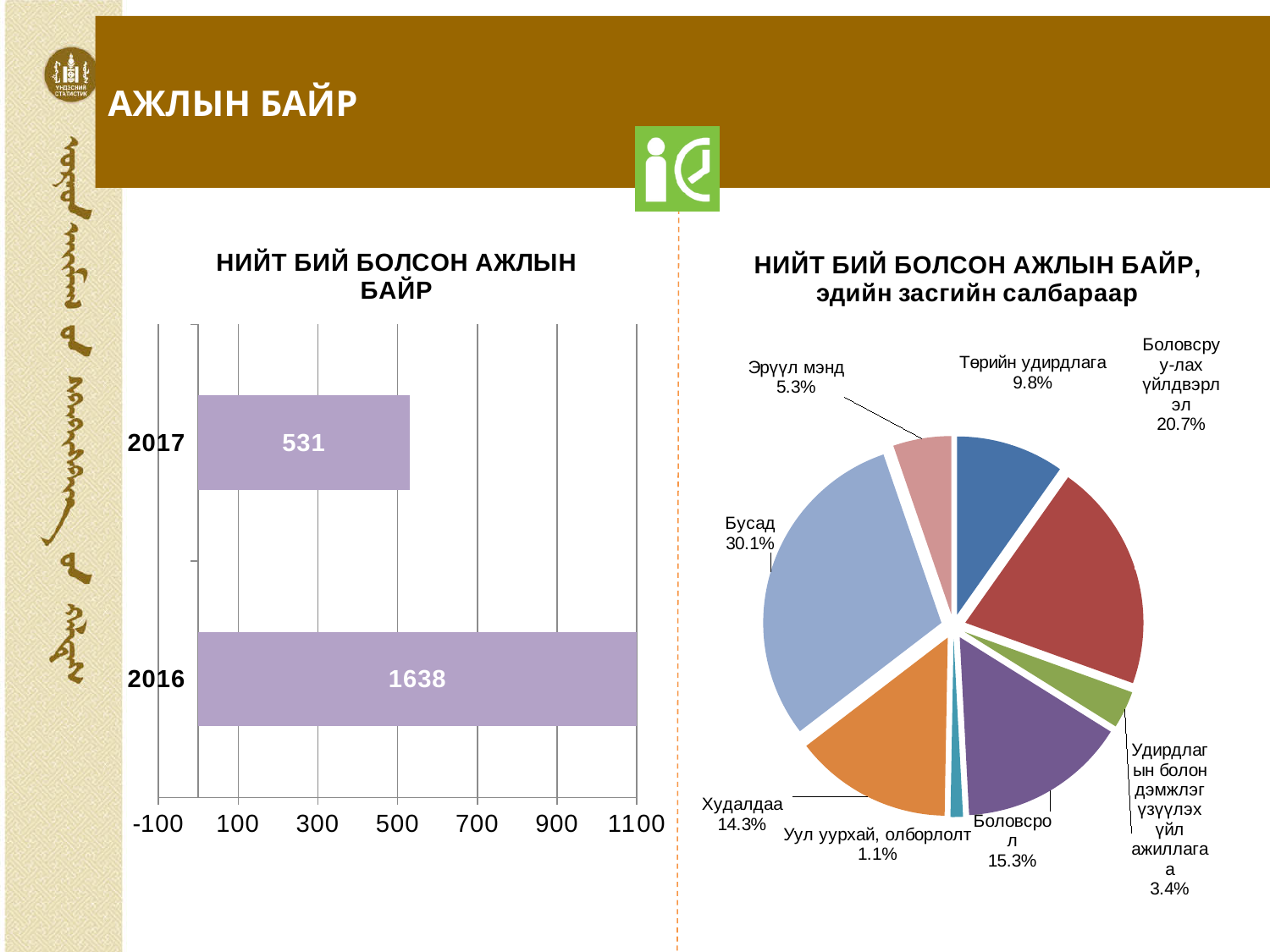
What kind of chart is the chart on the left of the slide? Bar chart In the pie chart on the right, what share does 'Боловсрол' have? 15.3% In the bar chart titled 'НИЙТ БИЙ БОЛСОН АЖЛЫН БАЙР', what is the value for 2016? 1638 In the pie chart on the right, how many slices are there? 8 In the pie chart on the right, which sector has the smallest share? Уул уурхай, олборлолт In the pie chart titled 'НИЙТ БИЙ БОЛСОН АЖЛЫН БАЙР, эдийн засгийн салбараар', what share does 'Бусад' have? 30.1% In the pie chart on the right, which is larger, the share for 'Худалдаа' or the share for 'Төрийн удирдлага'? Худалдаа In the pie chart on the right, which sector has the largest share? Бусад In the bar chart on the left, what is the difference between the 2016 and 2017 values? 1107 How many categories are shown in the bar chart on the left? 2 In the bar chart titled 'НИЙТ БИЙ БОЛСОН АЖЛЫН БАЙР', what is the value for 2017? 531 In the bar chart on the left, which year has the higher value, 2016 or 2017? 2016